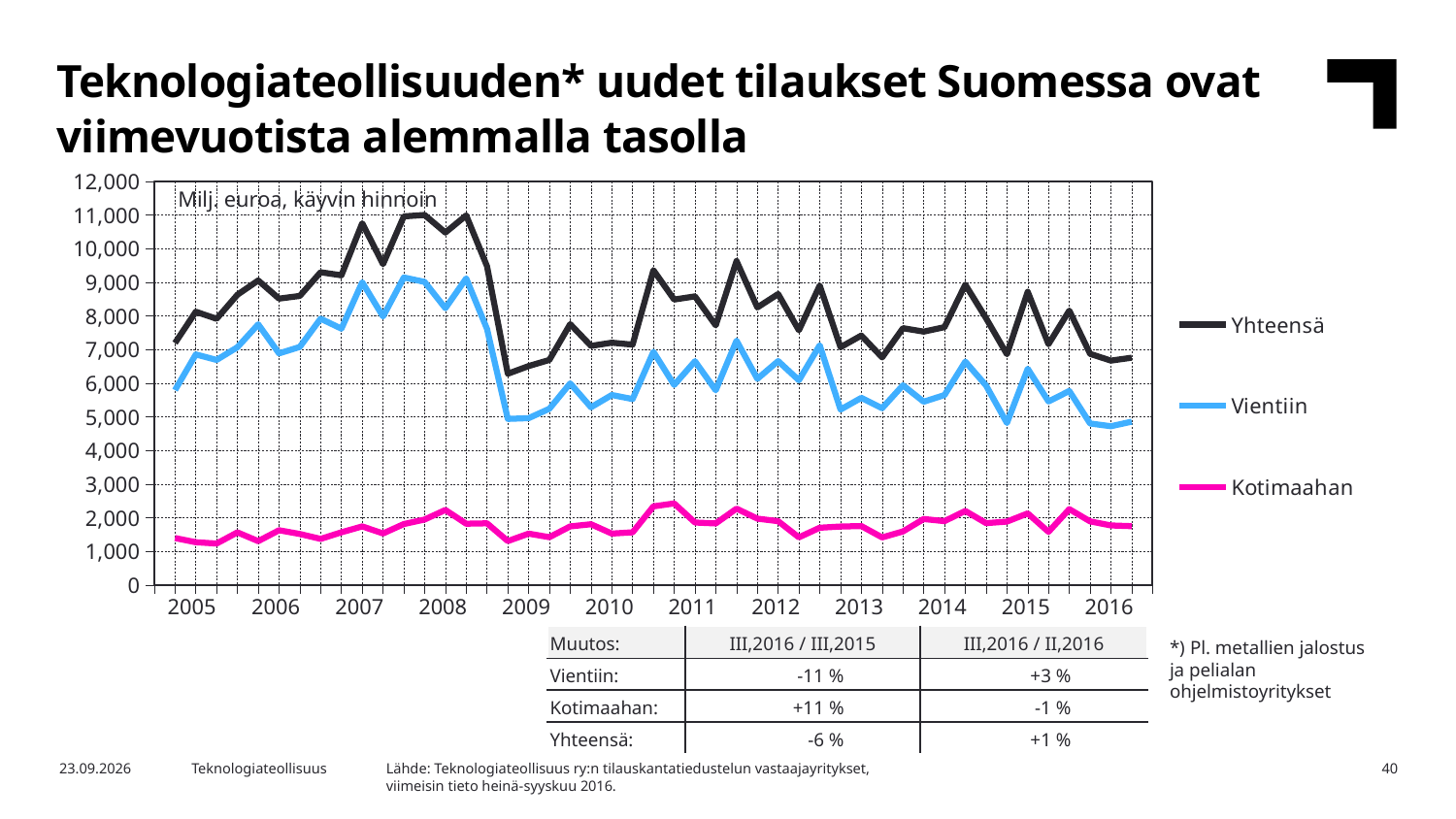
What kind of chart is shown on the slide? Line chart Is the value for Kotimaahan in 2005 greater or less than 3,000? less Which series are listed in the chart legend? Yhteensä, Vientiin, Kotimaahan Does the Yhteensä series rise or fall from 2008 to 2009? fall How many years are labelled on the x axis of the chart? 12 Which is larger in 2016, the value for Vientiin or the value for Kotimaahan? Vientiin How many series does the chart legend list? 3 Which series has the highest values throughout the chart? Yhteensä Which series has the lowest values throughout the chart? Kotimaahan What unit label is printed inside the chart area? Milj. euroa, käyvin hinnoin Is the value for Vientiin at the end of 2016 greater or less than 6,000? less Is the peak value of Yhteensä in 2008 greater or less than 10,000? greater